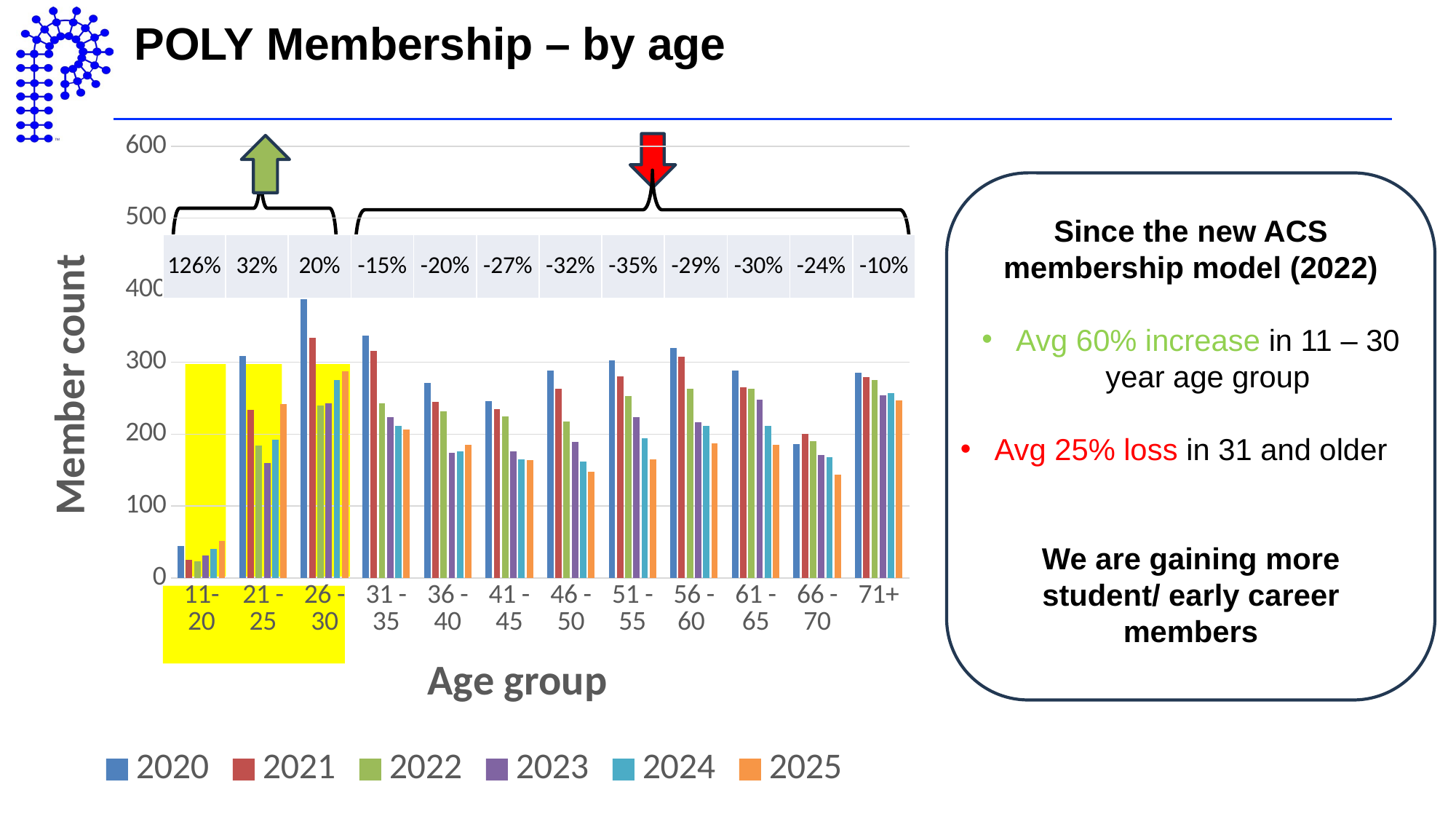
Is the 2020 value for the 11-20 age group greater or less than 100? less What percentage change is printed above the 51-55 age group? -35% Which age group has the largest percentage decline printed above it? 51 - 55 Which age group has the lowest member count across all years? 11 - 20 How many series does the legend list? 6 What percentage change is printed above the 11-20 age group? 126% How many age groups are shown on the x axis? 12 Which age group has the highest 2020 member count? 26 - 30 For the 51-55 age group, which is larger, the 2020 value or the 2025 value? 2020 What kind of chart is shown on the slide? bar chart What percentage change is printed above the 71+ age group? -10% Is the 2020 value for the 26-30 age group greater or less than 300? greater